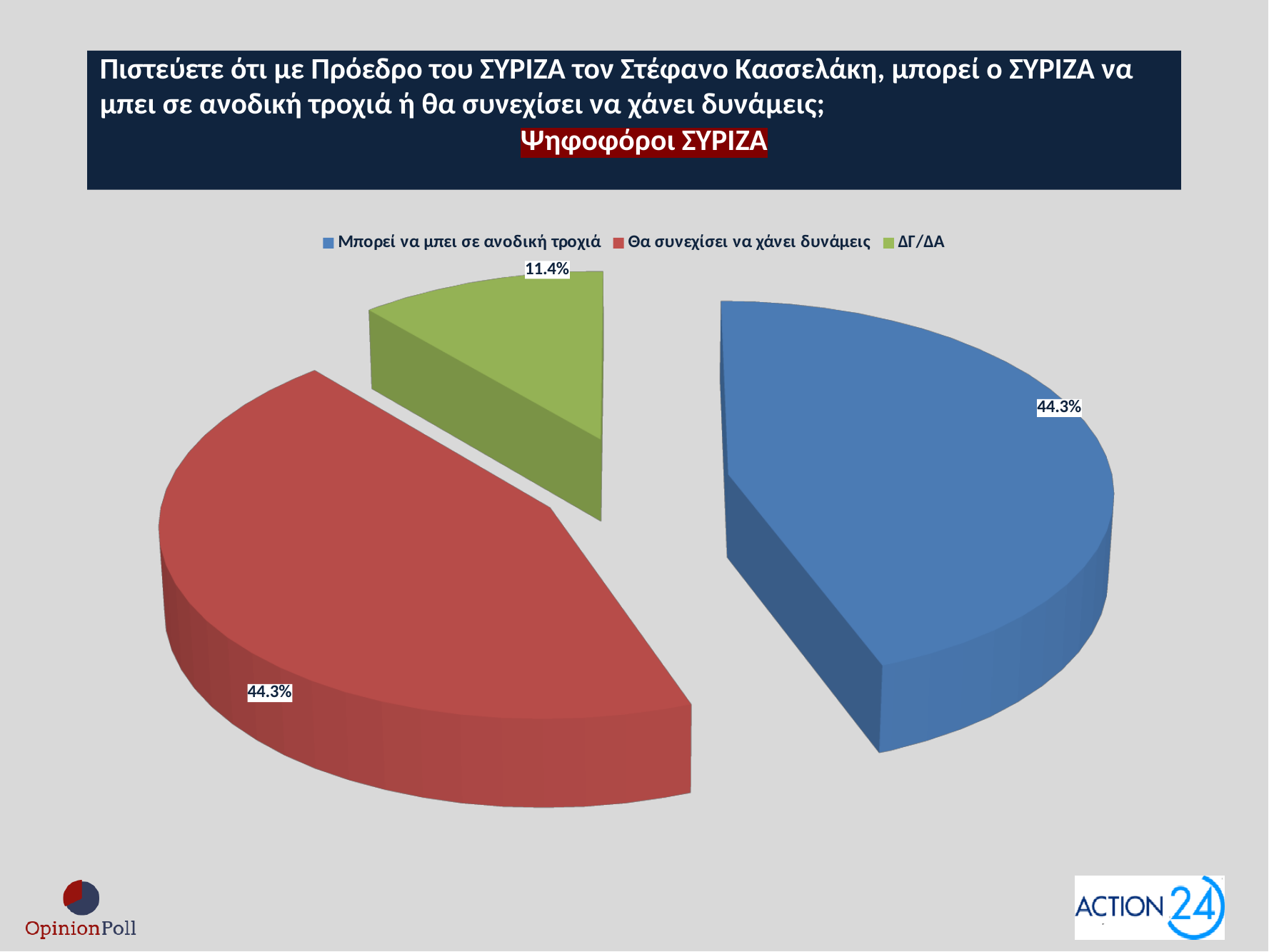
Which group of voters does the chart refer to, according to the subtitle? Ψηφοφόροι ΣΥΡΙΖΑ What kind of chart is shown on the slide? pie chart Which is larger: the slice for "Μπορεί να μπει σε ανοδική τροχιά" or the slice for "ΔΓ/ΔΑ"? Μπορεί να μπει σε ανοδική τροχιά Which category has the smallest slice of the pie? ΔΓ/ΔΑ How many entries does the legend list? 3 What percentage of SYRIZA voters answered "Θα συνεχίσει να χάνει δυνάμεις"? 44.3% What percentage of SYRIZA voters answered "Μπορεί να μπει σε ανοδική τροχιά"? 44.3% What colour is the slice for "Θα συνεχίσει να χάνει δυνάμεις"? red What share of the pie does the "ΔΓ/ΔΑ" slice represent? 11.4% What percentage is shown for "ΔΓ/ΔΑ"? 11.4% How many slices does the pie chart have? 3 What is the difference in percentage points between "Θα συνεχίσει να χάνει δυνάμεις" and "ΔΓ/ΔΑ"? 32.9 percentage points